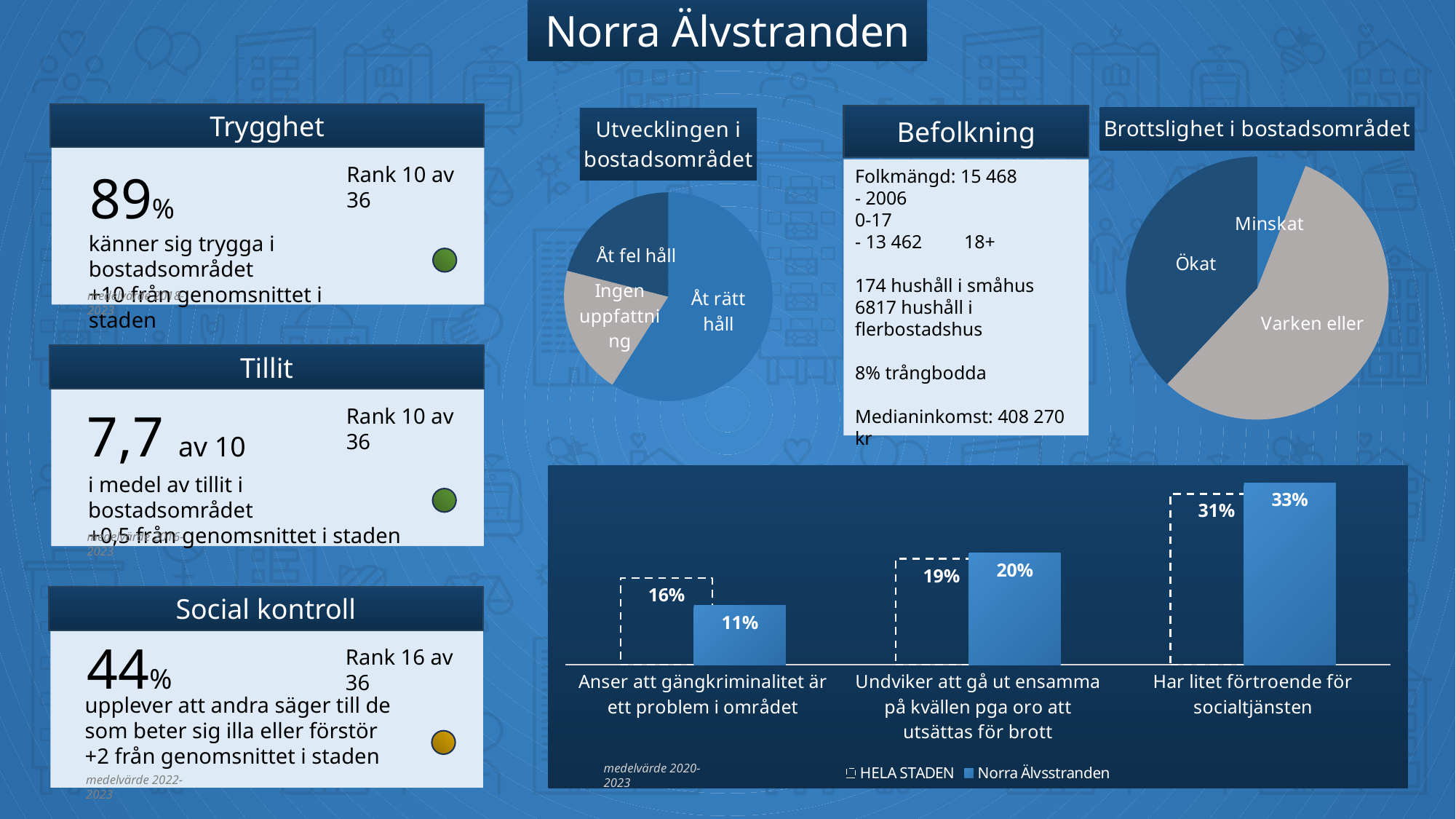
In the bar chart at the bottom of the slide, what is the value for Norra Älvsstranden for 'Har litet förtroende för socialtjänsten'? 33% In the bar chart at the bottom of the slide, what is the difference between HELA STADEN and Norra Älvsstranden for 'Anser att gängkriminalitet är ett problem i området'? 5% What kind of chart is 'Utvecklingen i bostadsområdet'? Pie chart In the pie chart 'Brottslighet i bostadsområdet', which slice is the largest? Varken eller How many slices does the pie chart 'Utvecklingen i bostadsområdet' have? 3 In the bar chart at the bottom of the slide, which category has the lowest value for HELA STADEN? Anser att gängkriminalitet är ett problem i området In the bar chart at the bottom of the slide, what is the value for HELA STADEN for 'Undviker att gå ut ensamma på kvällen pga oro att utsättas för brott'? 19% In the bar chart at the bottom of the slide, what is the value for Norra Älvsstranden for 'Anser att gängkriminalitet är ett problem i området'? 11% In the bar chart at the bottom of the slide, which is larger for 'Har litet förtroende för socialtjänsten': HELA STADEN or Norra Älvsstranden? Norra Älvsstranden How many series does the legend of the bar chart at the bottom of the slide list? 2 In the bar chart at the bottom of the slide, which category has the highest value for Norra Älvsstranden? Har litet förtroende för socialtjänsten How many categories are shown in the bar chart at the bottom of the slide? 3